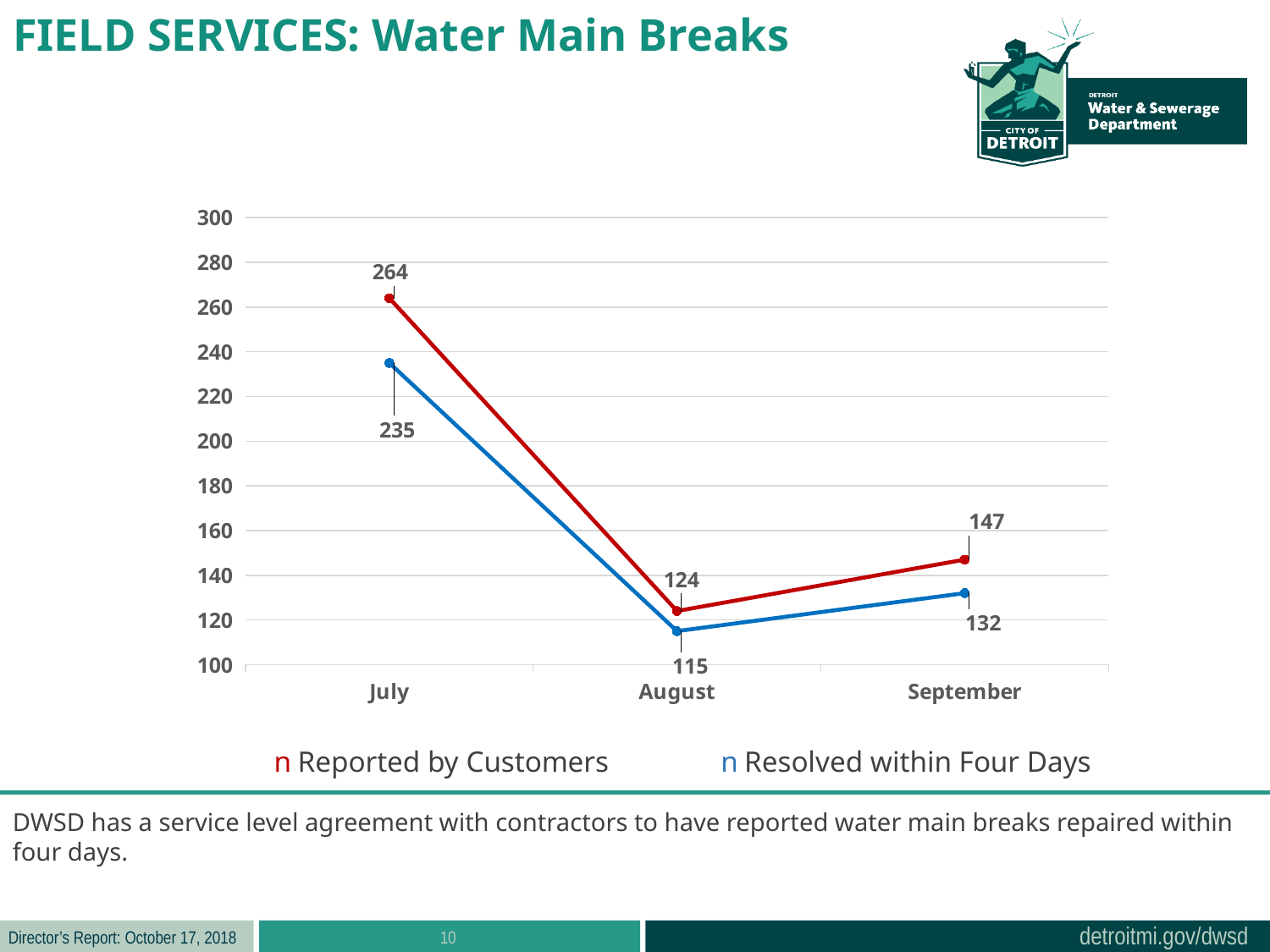
How many series does the legend list? 2 Which is larger: breaks reported by customers in August or breaks resolved within four days in September? Breaks resolved within four days in September In which month was the number of breaks resolved within four days highest? July What kind of chart is shown on the slide? Line chart In which month was the number of breaks reported by customers lowest? August Did the number of breaks reported by customers rise or fall from July to August? Fall What is the difference between breaks reported by customers and breaks resolved within four days in July? 29 How many water main breaks were resolved within four days in August? 115 How many water main breaks were reported by customers in September? 147 What is the difference between breaks reported by customers and breaks resolved within four days in September? 15 How many months are shown on the x axis? 3 How many water main breaks were reported by customers in July? 264